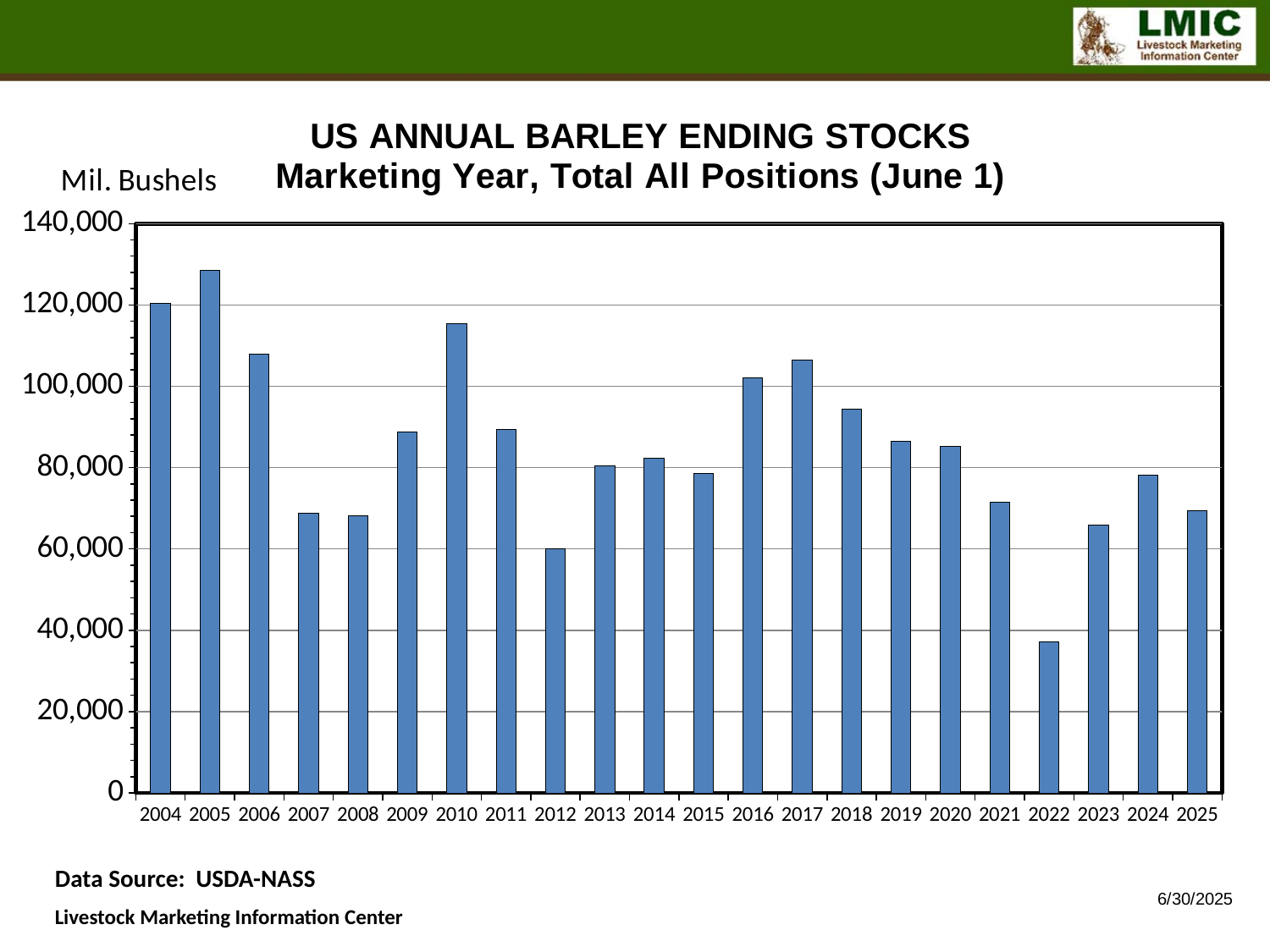
Which year has the larger value, 2022 or 2023? 2023 Is the value for 2018 greater or less than 100,000? less Which year has the highest barley ending stocks? 2005 Is the value for 2022 greater or less than 40,000? less Which year has the larger value, 2010 or 2017? 2010 Which year has the lowest barley ending stocks? 2022 Is the value for 2007 greater or less than 80,000? less How many years are plotted on the x axis? 22 What unit is shown for the y axis? Mil. Bushels Overall, do the values rise or fall from 2004 to 2025? fall What kind of chart is shown on the slide? bar chart